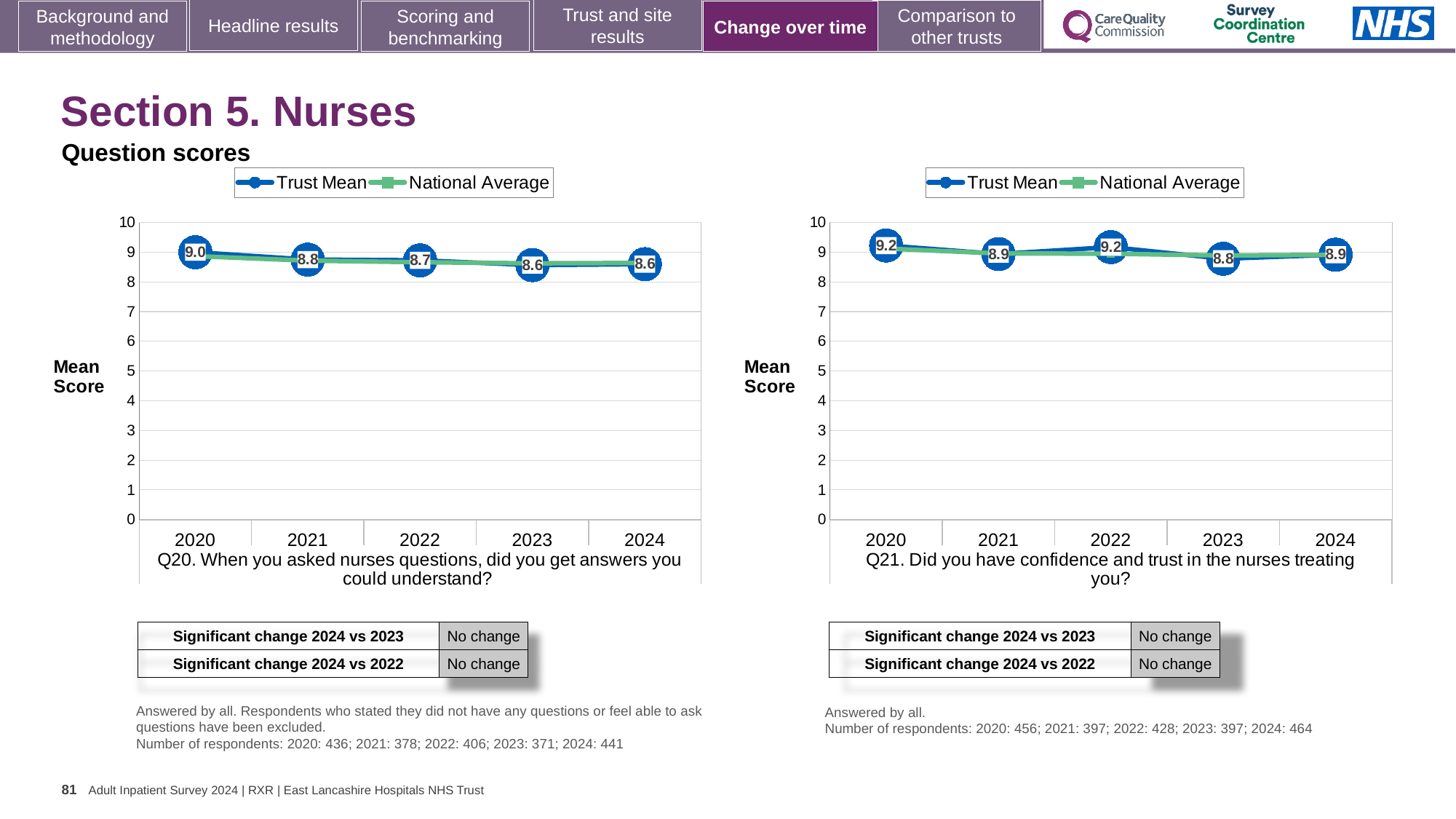
In the Q21 chart (right), what is the Trust Mean score for 2023? 8.8 In the Q20 chart (left), what is the Trust Mean score for 2020? 9.0 What type of chart is used for the Q20 question scores on the left? Line chart In the Q20 chart (left), what is the Trust Mean score for 2024? 8.6 In the Q21 chart (right), what is the Trust Mean score for 2024? 8.9 In the Q21 chart (right), which year has the lowest Trust Mean score? 2023 In the Q21 chart (right), how many series does the legend list? 2 In the Q20 chart (left), what is the difference between the Trust Mean scores for 2020 and 2024? 0.4 In the Q20 chart (left), which year has the highest Trust Mean score? 2020 In the Q20 chart (left), how many years are plotted on the x axis? 5 In the Q20 chart (left), does the Trust Mean score rise or fall from 2020 to 2024? fall In the Q21 chart (right), is the Trust Mean score for 2022 larger or smaller than the score for 2021? larger